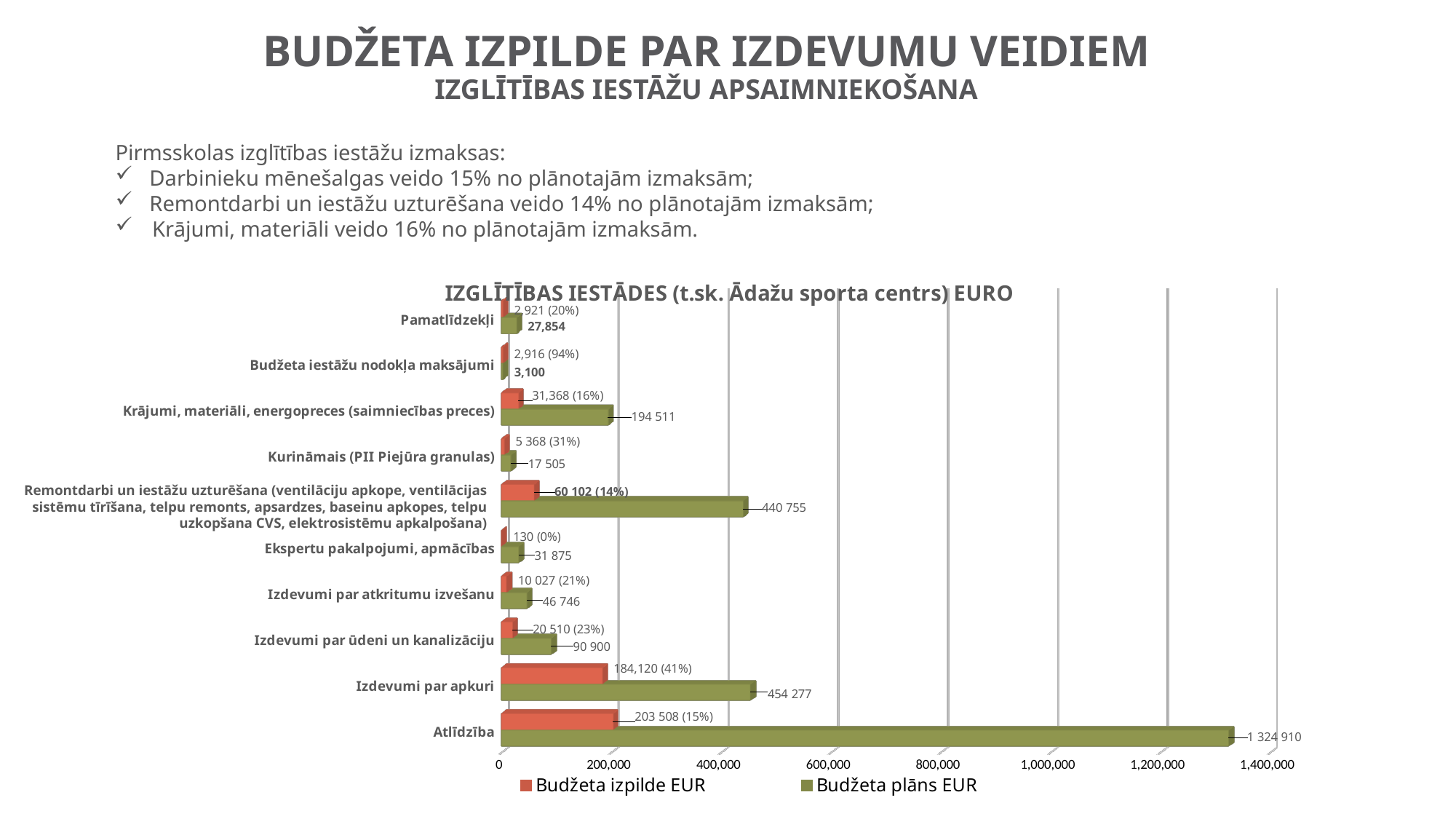
Which category has the highest Budžeta plāns EUR value? Atlīdzība How many series does the chart legend list? 2 What is the difference between the Budžeta plāns EUR and Budžeta izpilde EUR values for Izdevumi par atkritumu izvešanu? 36 719 Which category has the lowest Budžeta izpilde EUR value? Ekspertu pakalpojumi, apmācības Which is larger: the Budžeta plāns EUR value for Izdevumi par apkuri or for Remontdarbi un iestāžu uzturēšana? Izdevumi par apkuri What is the Budžeta plāns EUR value for Atlīdzība? 1 324 910 What type of chart is shown on the slide? bar chart What is the Budžeta plāns EUR value for Izdevumi par ūdeni un kanalizāciju? 90 900 How many categories are shown on the chart? 10 What is the Budžeta izpilde EUR value for Izdevumi par apkuri? 184,120 What is the title of the chart? IZGLĪTĪBAS IESTĀDES (t.sk. Ādažu sporta centrs) EURO Is the Budžeta plāns EUR value for Atlīdzība greater or less than 1,200,000? greater